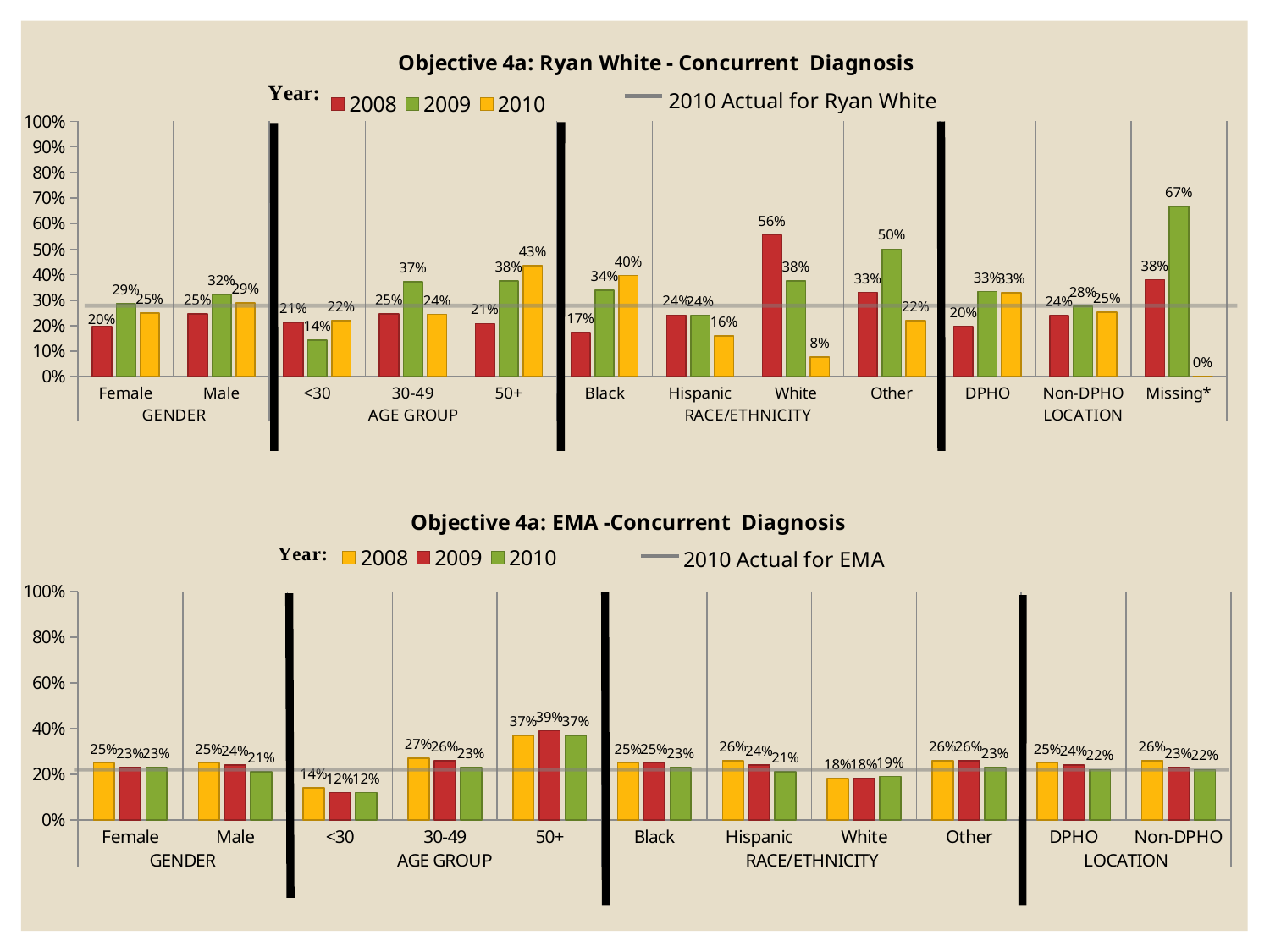
In the 'Objective 4a: Ryan White - Concurrent Diagnosis' chart, what is the difference between the 2008 and 2010 values for White? 48% In the 'Objective 4a: Ryan White - Concurrent Diagnosis' chart, what is the 2008 value for White? 56% How many years does the legend of the 'Objective 4a: EMA - Concurrent Diagnosis' chart list? 3 In the 'Objective 4a: Ryan White - Concurrent Diagnosis' chart, how do the values for Black change from 2008 to 2010? They rise In the 'Objective 4a: EMA - Concurrent Diagnosis' chart, how many categories are shown on the x axis? 11 In the 'Objective 4a: Ryan White - Concurrent Diagnosis' chart, which category has the lowest 2010 value? Missing* In the 'Objective 4a: EMA - Concurrent Diagnosis' chart, is the 2008 value for Hispanic larger or smaller than the 2008 value for White? Larger In the 'Objective 4a: EMA - Concurrent Diagnosis' chart, which category has the lowest 2008 value? <30 In the 'Objective 4a: EMA - Concurrent Diagnosis' chart, what is the 2009 value for 50+? 39% In the 'Objective 4a: Ryan White - Concurrent Diagnosis' chart, which category has the highest 2010 value? 50+ What type of chart is the 'Objective 4a: Ryan White - Concurrent Diagnosis' chart? Bar chart In the 'Objective 4a: Ryan White - Concurrent Diagnosis' chart, what is the 2009 value for Missing*? 67%